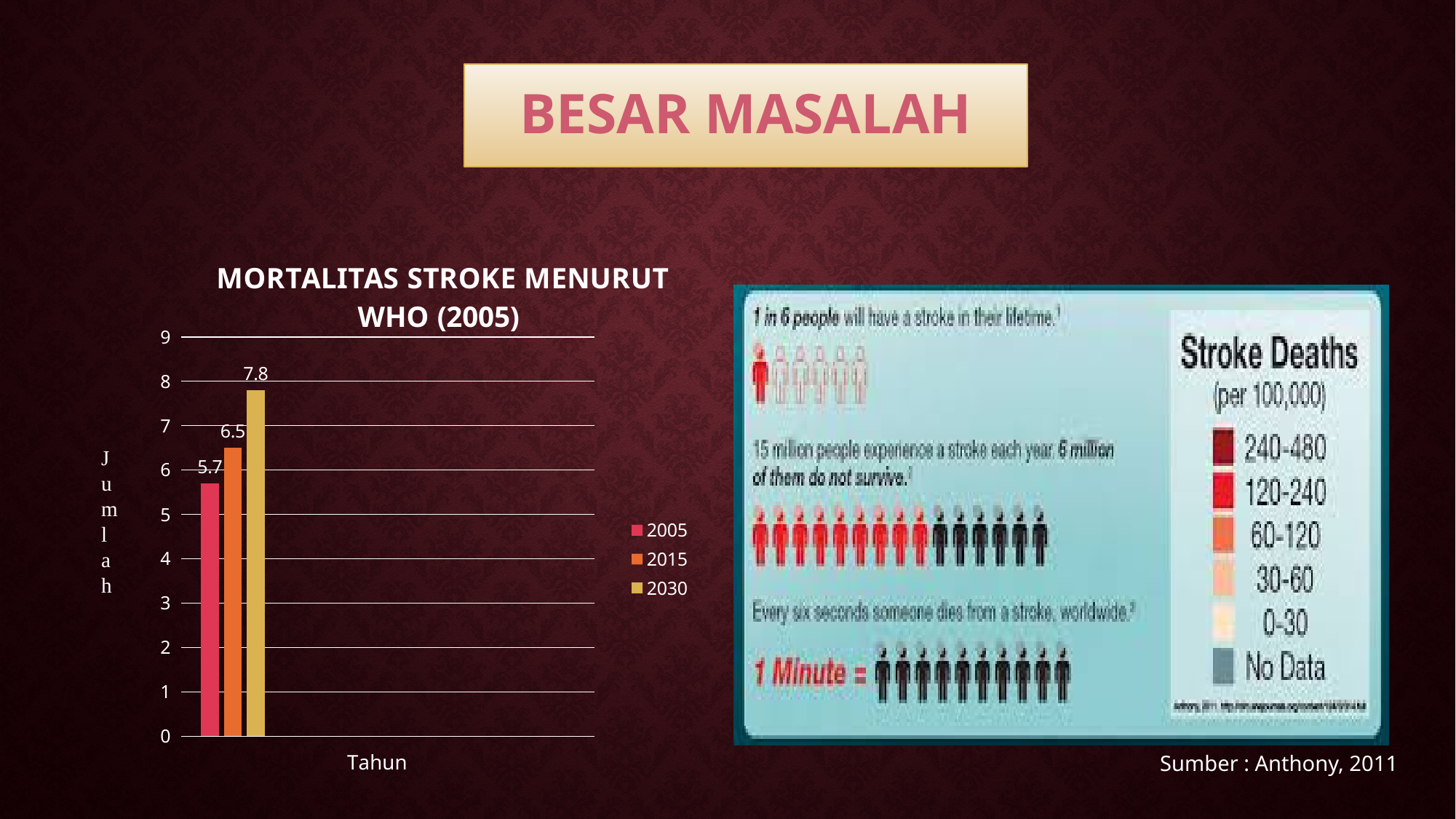
Do the values in the chart 'Mortalitas Stroke Menurut WHO (2005)' rise or fall from 2005 to 2030? Rise What is the difference between the values for 2015 and 2005 in the chart 'Mortalitas Stroke Menurut WHO (2005)'? 0.8 What is the value for 2030 in the chart 'Mortalitas Stroke Menurut WHO (2005)'? 7.8 What is the value for 2005 in the chart 'Mortalitas Stroke Menurut WHO (2005)'? 5.7 Which year has the highest value in the chart 'Mortalitas Stroke Menurut WHO (2005)'? 2030 Is the value for 2030 in the chart 'Mortalitas Stroke Menurut WHO (2005)' greater or less than 7? greater What kind of chart is 'Mortalitas Stroke Menurut WHO (2005)'? Bar chart Which year has the lowest value in the chart 'Mortalitas Stroke Menurut WHO (2005)'? 2005 What is the value for 2015 in the chart 'Mortalitas Stroke Menurut WHO (2005)'? 6.5 What is the difference between the values for 2030 and 2005 in the chart 'Mortalitas Stroke Menurut WHO (2005)'? 2.1 In the chart 'Mortalitas Stroke Menurut WHO (2005)', which is larger, the value for 2015 or the value for 2030? 2030 How many series does the legend of the chart 'Mortalitas Stroke Menurut WHO (2005)' list? 3